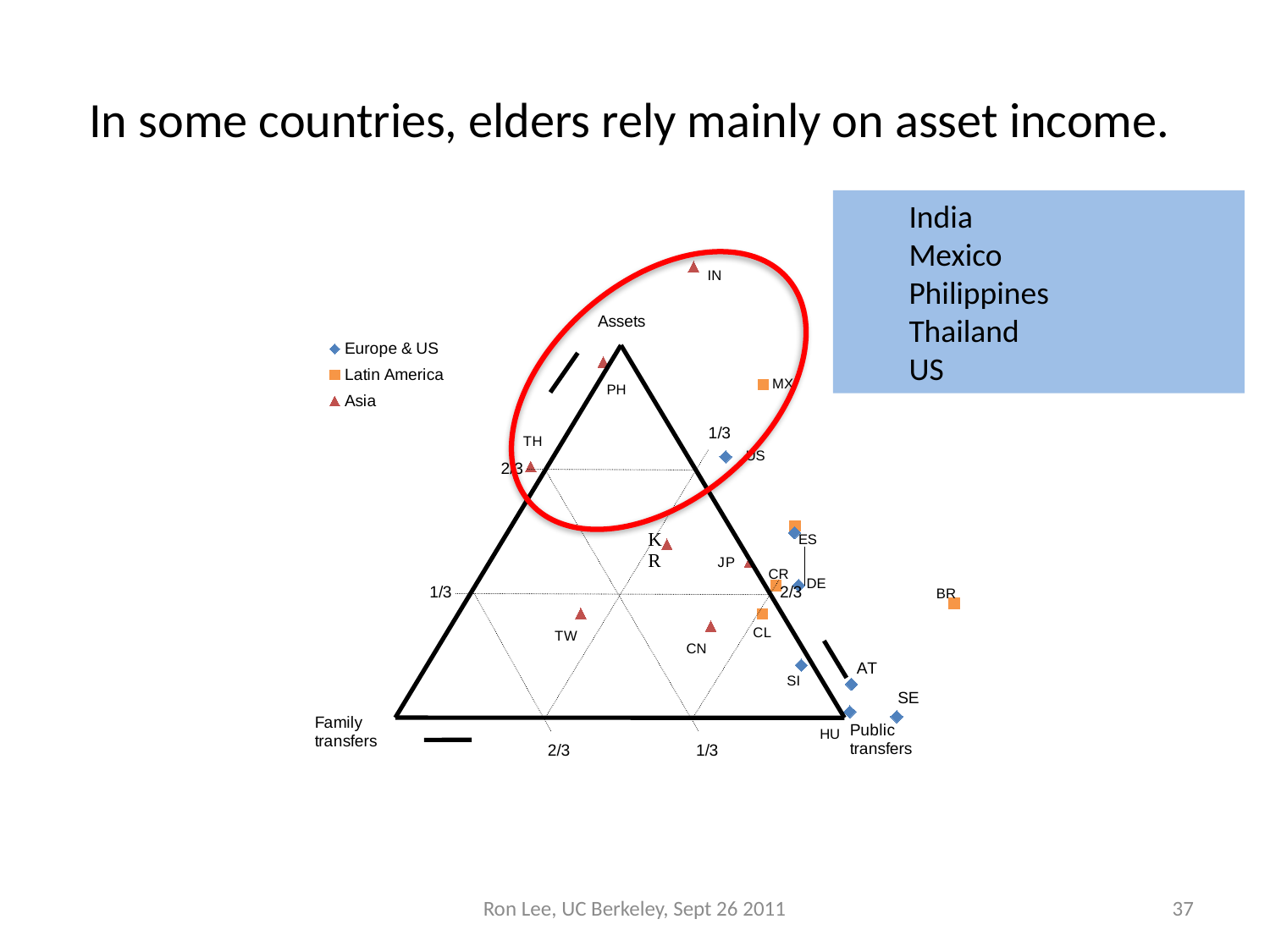
Which series does the point labeled DE belong to? Europe & US Which labeled point is plotted highest on the chart, closest to the Assets vertex? IN Is the asset share for IN greater or less than 2/3? greater What are the labels at the three corners of the triangle? Assets, Family transfers, Public transfers Which series does the point labeled IN belong to? Asia What are the three series named in the legend? Europe & US, Latin America, Asia Which point has the higher asset share, PH or TW? PH How many series does the legend list? 3 What kind of chart is shown on the slide? Ternary (triangle) scatter plot Which labeled point is plotted closest to the Public transfers corner of the triangle? HU Is the asset share for CN greater or less than 1/3? less Which series does the point labeled MX belong to? Latin America